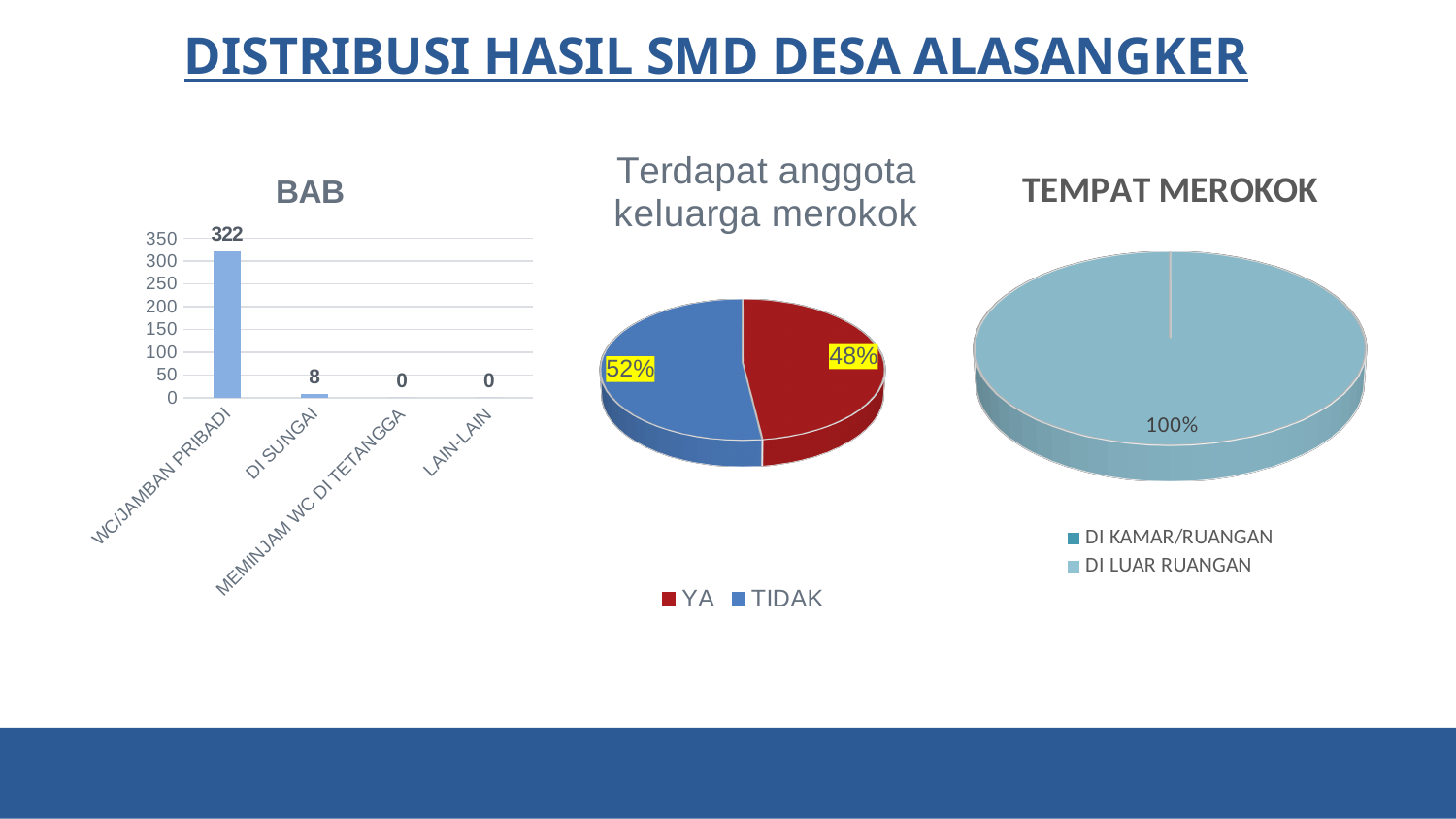
What kind of chart is the TEMPAT MEROKOK chart? pie chart In the BAB chart, which category has the highest value? WC/JAMBAN PRIBADI What kind of chart is the BAB chart? bar chart In the BAB chart, is the value for WC/JAMBAN PRIBADI greater or less than 300? greater In the BAB chart, how many categories are shown on the x axis? 4 In the 'Terdapat anggota keluarga merokok' chart, what share is labelled TIDAK? 52% In the BAB chart, what is the value for DI SUNGAI? 8 How many entries does the legend of the TEMPAT MEROKOK chart list? 2 In the 'Terdapat anggota keluarga merokok' chart, what share is labelled YA? 48% In the BAB chart, what is the difference between WC/JAMBAN PRIBADI and DI SUNGAI? 314 In the 'Terdapat anggota keluarga merokok' chart, which slice is larger, YA or TIDAK? TIDAK In the BAB chart, what is the value for WC/JAMBAN PRIBADI? 322